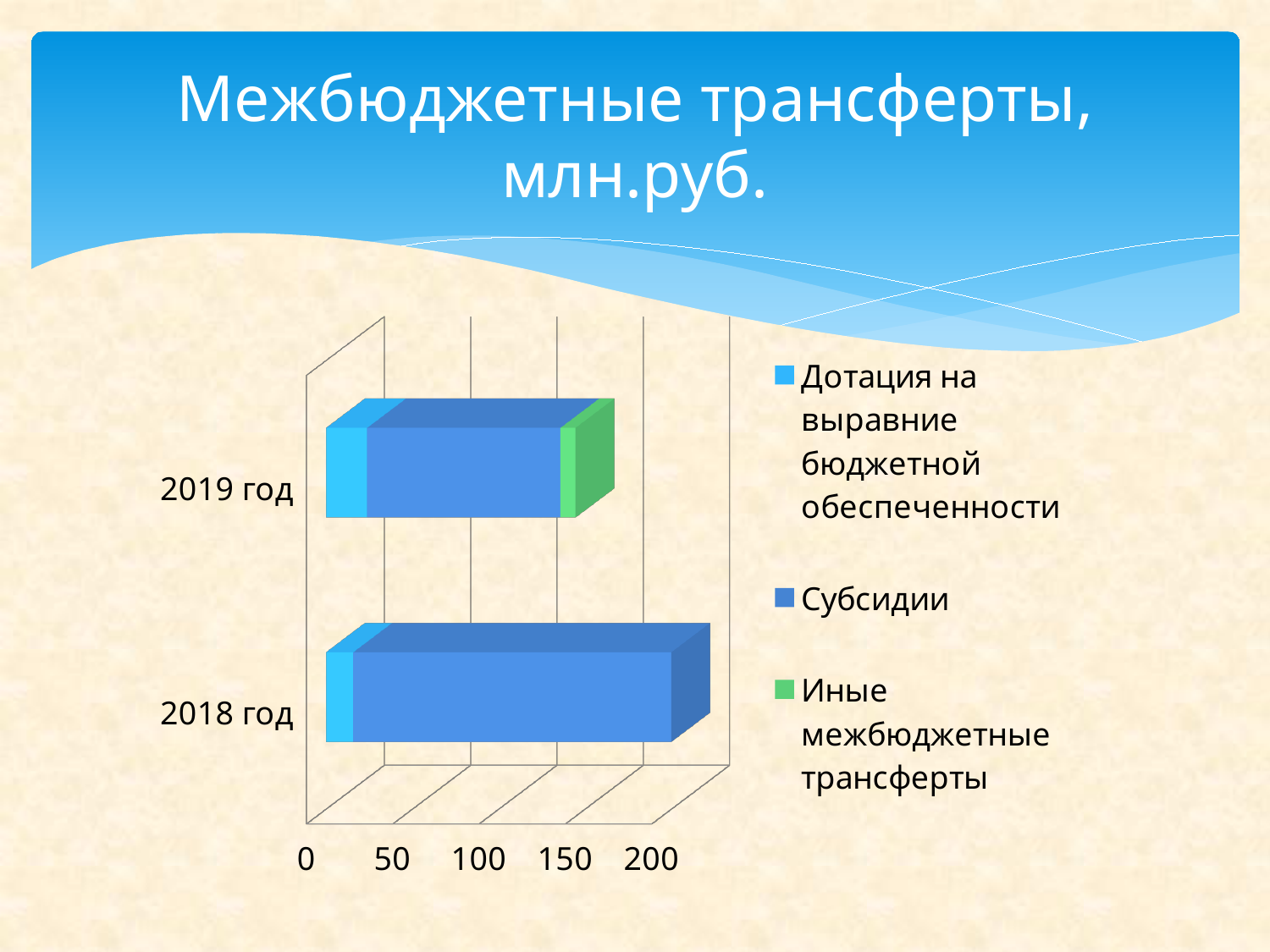
Which series is shown in green in the legend? Иные межбюджетные трансферты What kind of chart is shown on the slide? bar chart Is the Дотация на выравние бюджетной обеспеченности segment for 2019 год greater or less than 50? less Is the total bar for 2019 год greater or less than 100? greater Which year has the larger total bar, 2018 год or 2019 год? 2018 год What is the title of the chart on the slide? Межбюджетные трансферты, млн.руб. Is the Субсидии segment for 2018 год greater or less than 150? greater How many series does the legend list? 3 How many categories (years) are shown on the chart? 2 Which year has the larger Субсидии segment, 2018 год or 2019 год? 2018 год